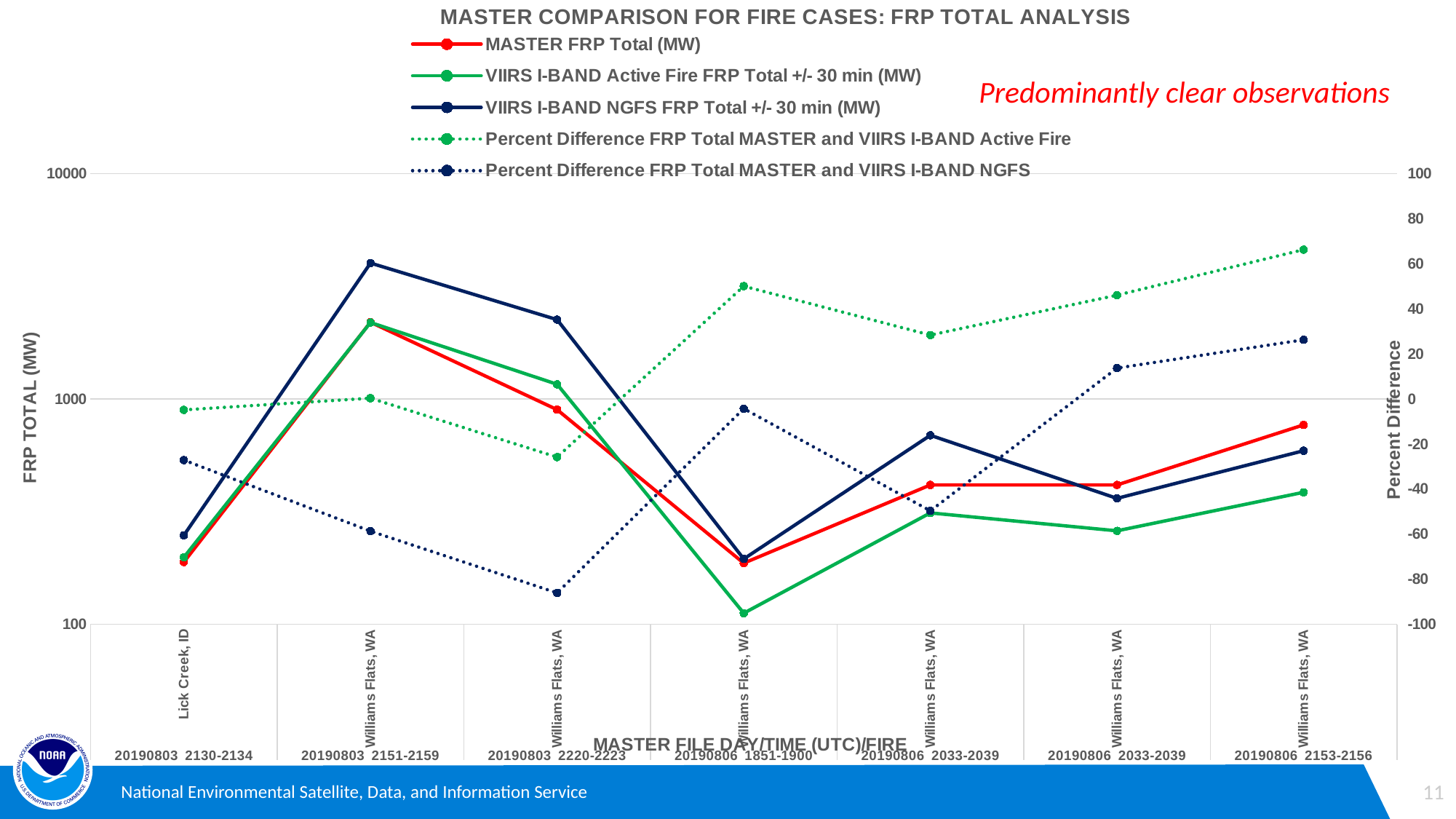
How many data points (MASTER file day/time cases) are plotted along the x axis? 7 Is the VIIRS I-BAND Active Fire FRP Total at 20190806 1851-1900 greater or less than 1000? less Is the MASTER FRP Total (MW) at 20190803 2151-2159 greater or less than 1000? greater Is the Percent Difference FRP Total MASTER and VIIRS I-BAND Active Fire at 20190806 1851-1900 greater or less than 40? greater At 20190803 2151-2159, which is larger: the VIIRS I-BAND NGFS FRP Total or the MASTER FRP Total? VIIRS I-BAND NGFS FRP Total At which MASTER file day/time is the MASTER FRP Total (MW) highest? 20190803 2151-2159 What kind of chart is shown on the slide? line chart At which MASTER file day/time is the VIIRS I-BAND Active Fire FRP Total lowest? 20190806 1851-1900 What is the label of the right-hand vertical axis? Percent Difference At 20190806 2153-2156, which is larger: the MASTER FRP Total or the VIIRS I-BAND Active Fire FRP Total? MASTER FRP Total How many series does the legend list? 5 Does the Percent Difference FRP Total MASTER and VIIRS I-BAND Active Fire rise or fall from 20190806 2033-2039 to 20190806 2153-2156? rise